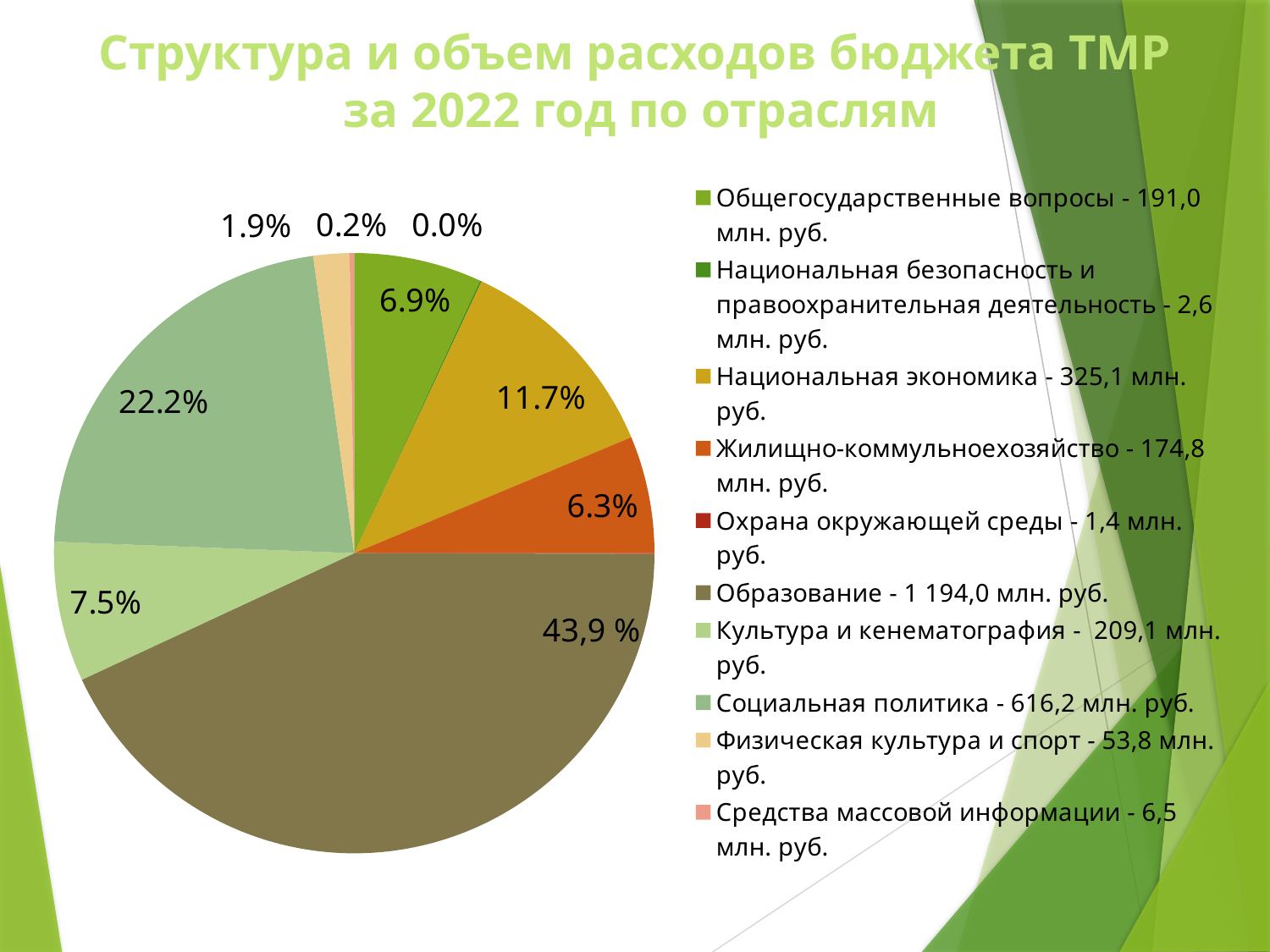
What share of the pie does Национальная экономика have? 11.7% What kind of chart is shown on the slide? pie chart What share of the pie does Культура и кенематография have? 7.5% What share of the pie does Социальная политика have? 22.2% How many categories does the legend of the pie chart list? 10 Which category has the largest slice of the pie chart? Образование According to the legend, what is the amount for Образование? 1 194,0 млн. руб. Which slice is larger: Социальная политика or Национальная экономика? Социальная политика According to the legend, what is the amount for Социальная политика? 616,2 млн. руб. What is the difference in percentage points between the Социальная политика slice (22.2%) and the Национальная экономика slice (11.7%)? 10.5